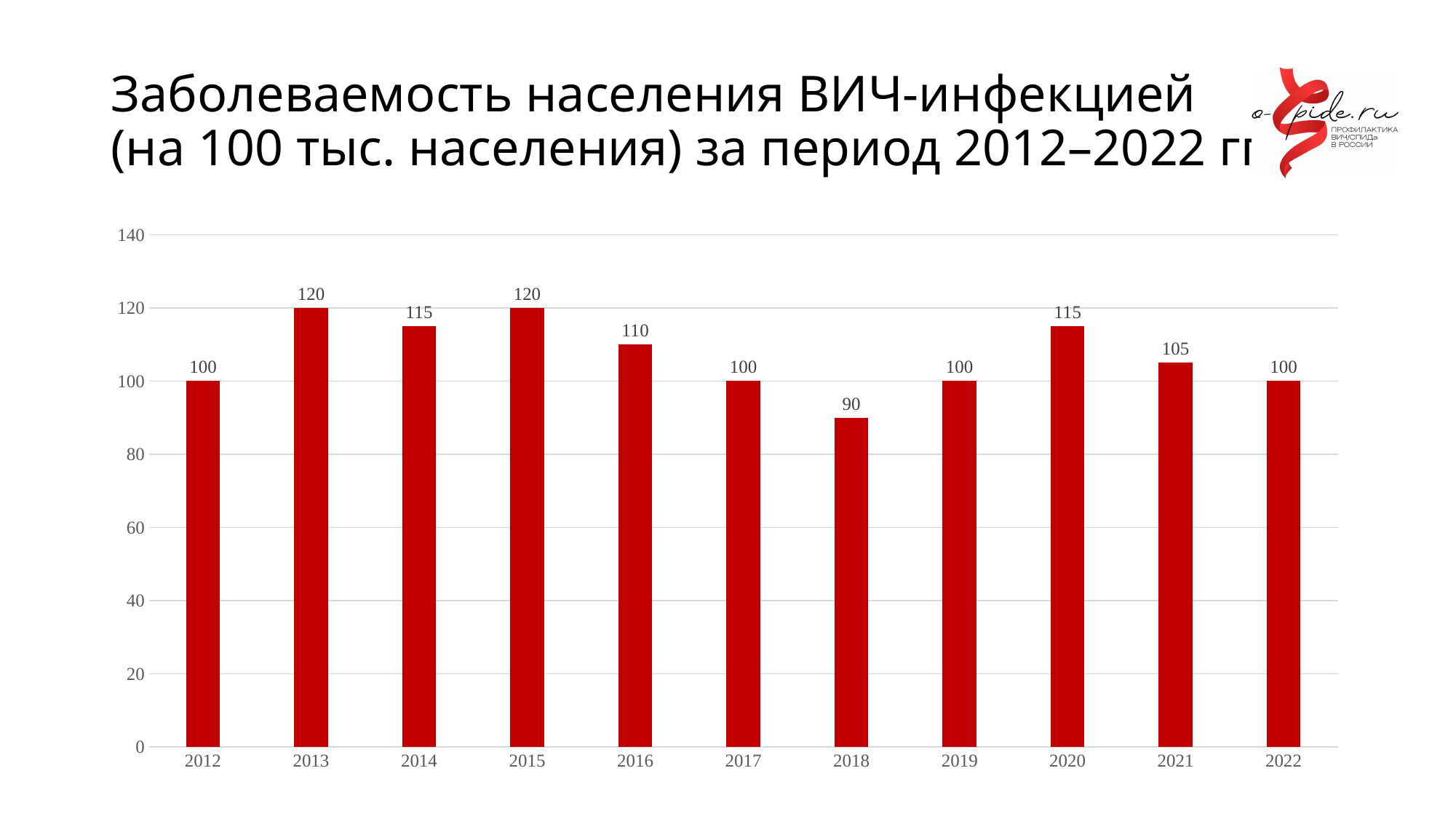
Which year has the lowest value? 2018 What is the value for 2016? 110 What is the value for 2018? 90 What is the value for 2020? 115 How many years are shown on the x axis? 11 What kind of chart is shown on the slide? bar chart What is the difference between the values for 2020 and 2021? 10 Is the value for 2015 greater or less than 100? greater What is the value for 2021? 105 What is the difference between the values for 2013 and 2018? 30 Do the values rise or fall from 2015 to 2018? fall Which is larger, the value for 2014 or the value for 2017? 2014